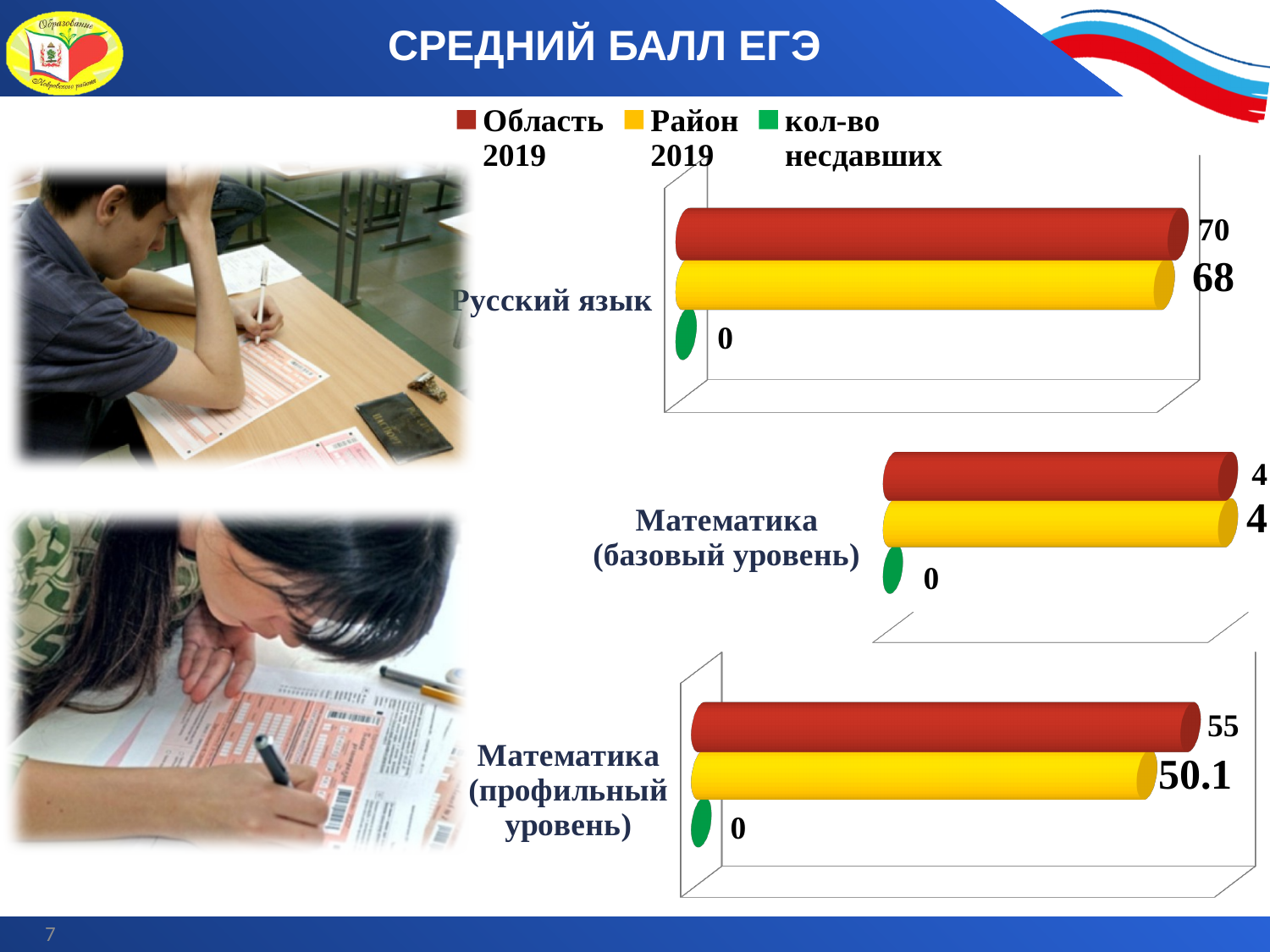
What kind of chart is used for Русский язык? bar chart In the Русский язык chart, which series has the lowest value? кол-во несдавших In the Математика (базовый уровень) chart, what is the value for Область 2019? 4 In the Математика (профильный уровень) chart, what is the value for Область 2019? 55 In the Русский язык chart, what is the value for кол-во несдавших? 0 In the Русский язык chart, what is the difference between Область 2019 and Район 2019? 2 In the Русский язык chart, what is the value for Район 2019? 68 In the Русский язык chart, what is the value for Область 2019? 70 In the Математика (профильный уровень) chart, what is the value for Район 2019? 50.1 In the Математика (профильный уровень) chart, which is larger, Область 2019 or Район 2019? Область 2019 In the Математика (профильный уровень) chart, what is the difference between Область 2019 and Район 2019? 4.9 How many series does the legend list? 3